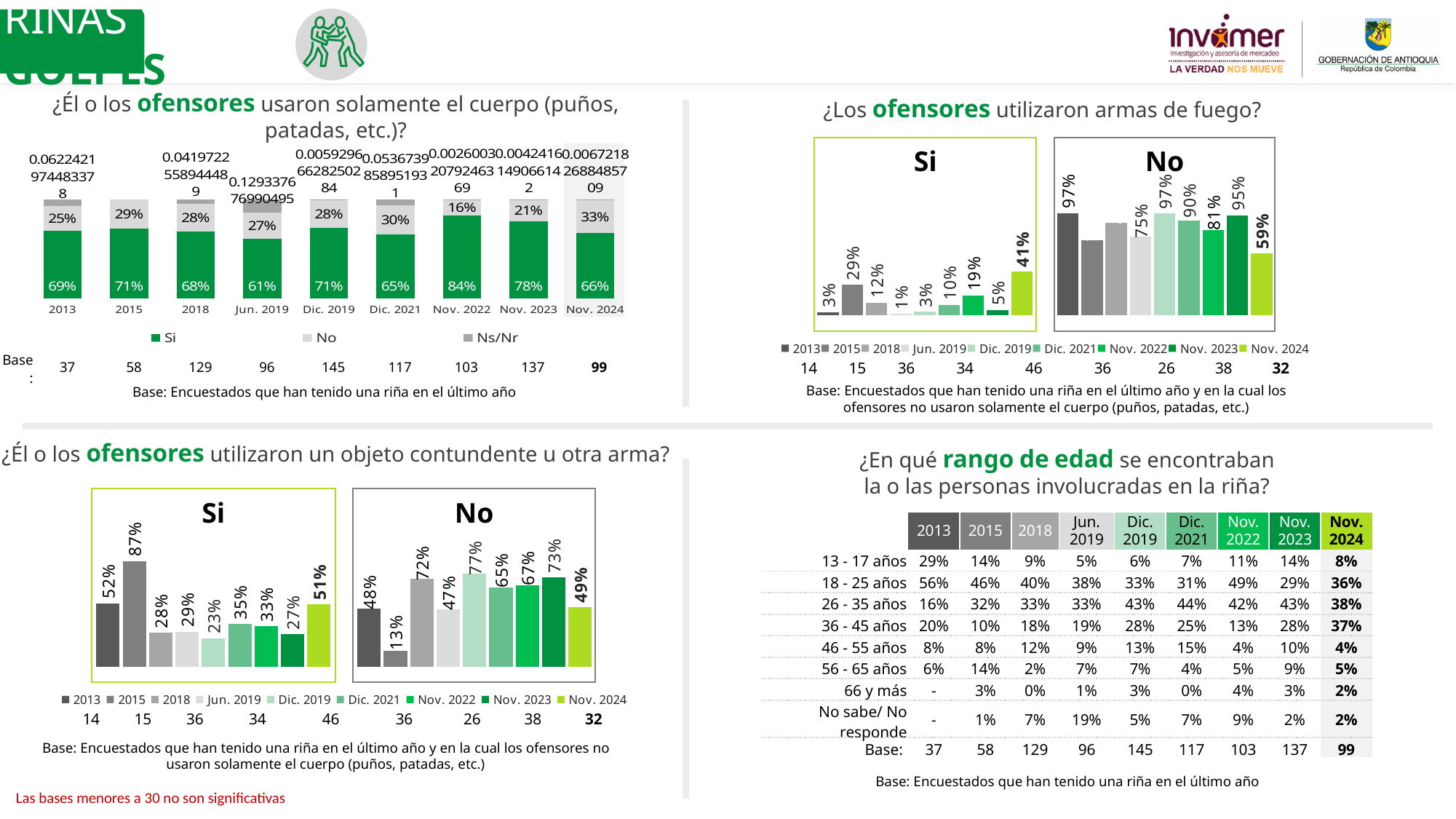
What kind of chart is '¿Él o los ofensores utilizaron un objeto contundente u otra arma?'? Bar chart In the chart '¿Los ofensores utilizaron armas de fuego?', what is the difference between the 'No' value for 2013 and the 'No' value for Nov. 2024? 38% In the chart '¿Los ofensores utilizaron armas de fuego?', which period has the highest 'Si' value? Nov. 2024 In the chart '¿Los ofensores utilizaron armas de fuego?', what is the 'Si' value for Nov. 2024? 41% In the chart '¿Él o los ofensores usaron solamente el cuerpo (puños, patadas, etc.)?', which period has the lowest 'Si' value? Jun. 2019 In the chart '¿Él o los ofensores usaron solamente el cuerpo (puños, patadas, etc.)?', how many periods are shown on the x axis? 9 In the chart '¿Él o los ofensores utilizaron un objeto contundente u otra arma?', which period has the lowest 'No' value? 2015 In the chart '¿Él o los ofensores usaron solamente el cuerpo (puños, patadas, etc.)?', how many series does the legend list? 3 In the chart '¿Él o los ofensores usaron solamente el cuerpo (puños, patadas, etc.)?', what is the 'Si' value for Nov. 2022? 84% In the chart '¿Él o los ofensores utilizaron un objeto contundente u otra arma?', which is larger: the 'Si' value for Nov. 2024 or the 'No' value for Nov. 2024? Si (51%) In the chart '¿Él o los ofensores utilizaron un objeto contundente u otra arma?', what is the 'Si' value for 2015? 87% In the chart '¿Él o los ofensores usaron solamente el cuerpo (puños, patadas, etc.)?', what is the 'No' value for Nov. 2024? 33%